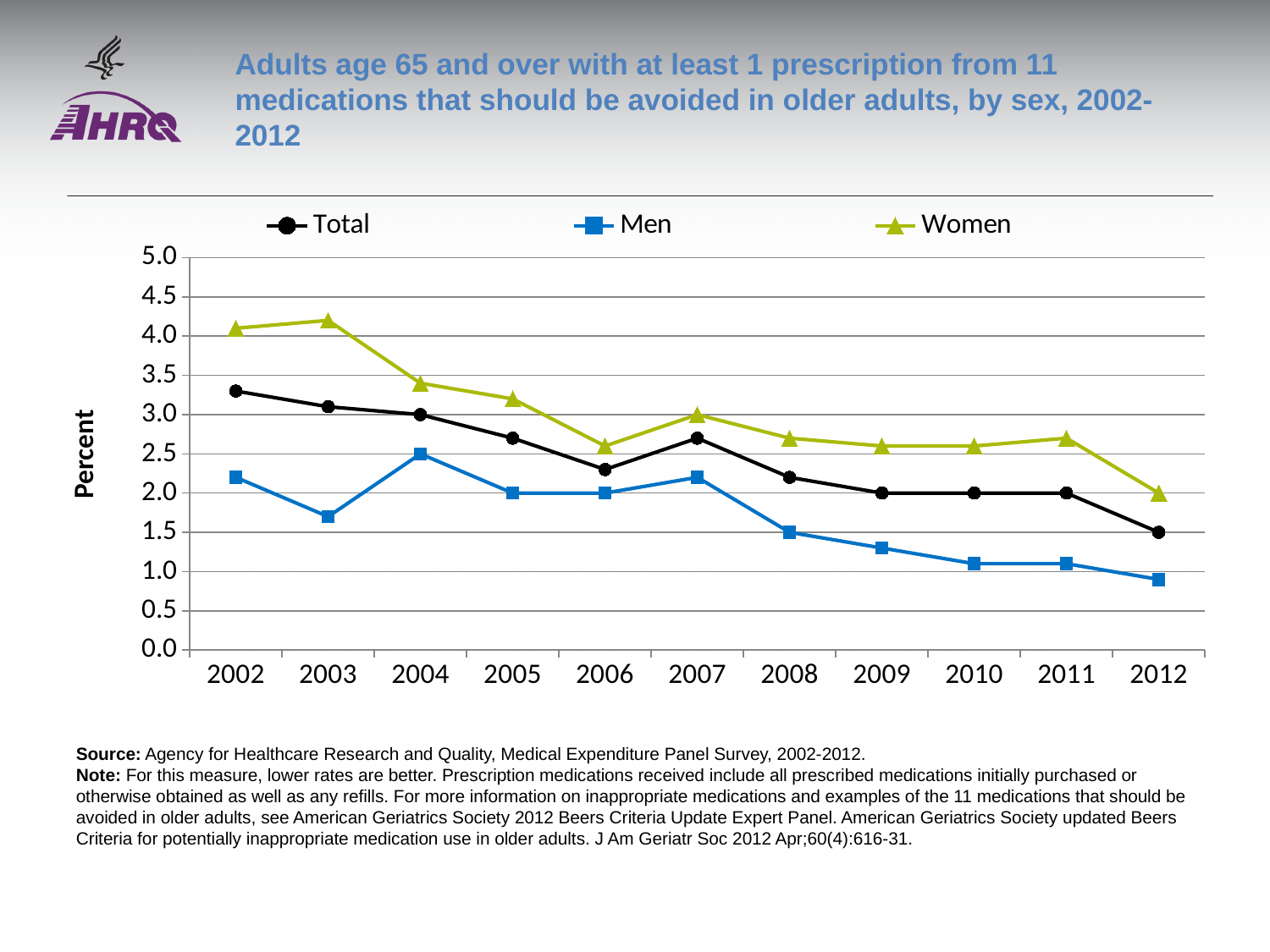
What kind of chart is shown on the slide? line chart How many series does the legend list? 3 What is the value for Women in 2012? 2.0 Is the value for Total in 2002 greater or less than 3.0? greater In 2002, which is larger, the value for Women or the value for Men? Women Is the value for Women in 2003 greater or less than 4.0? greater What is the value for Total in 2012? 1.5 What is the value for Men in 2008? 1.5 Is the value for Men in 2009 greater or less than 1.5? less How many years are plotted along the x axis? 11 Do the values for Total generally rise or fall from 2002 to 2012? fall In which year is the value for Men lowest? 2012